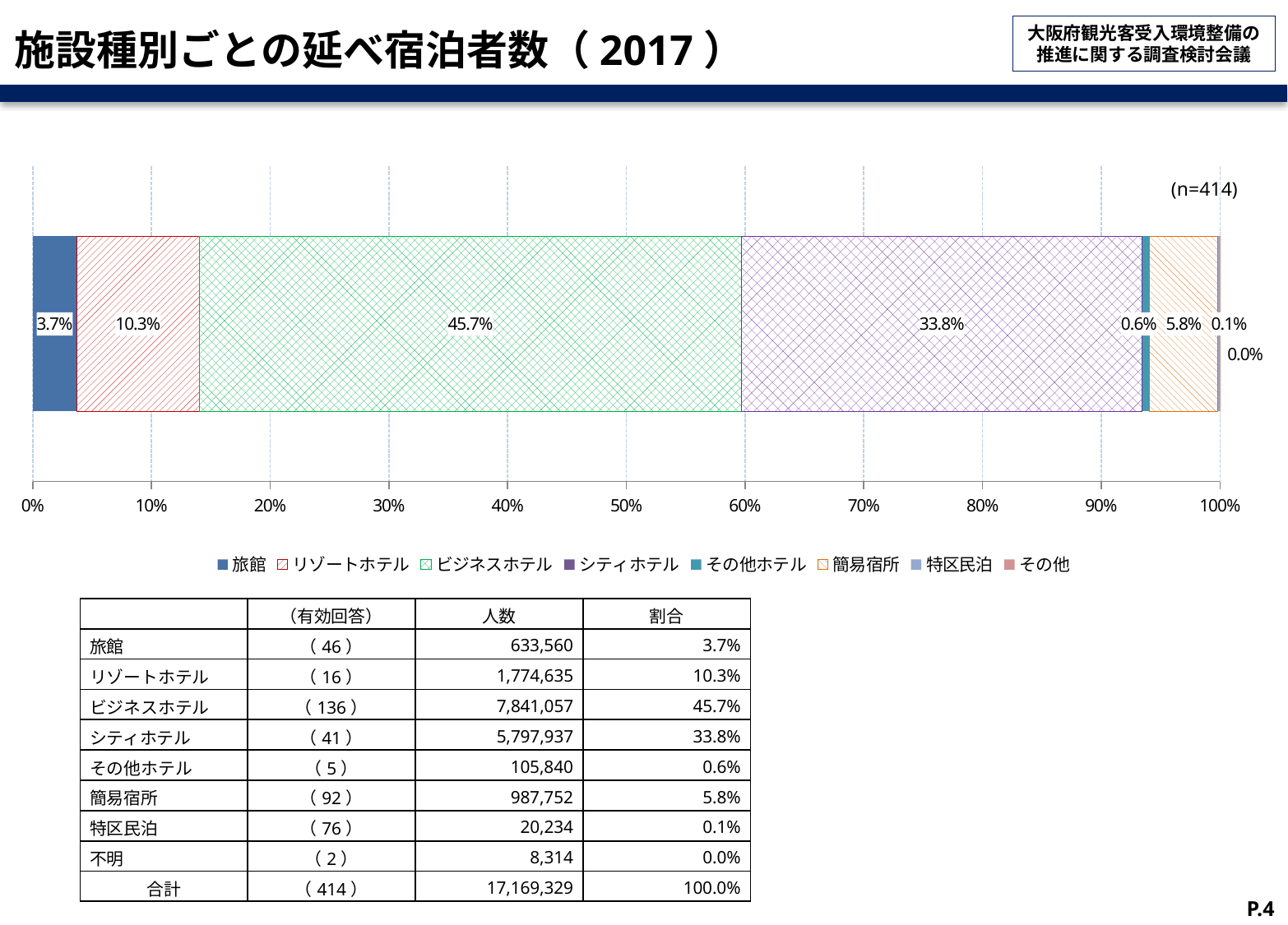
Which series has the smallest share in the stacked bar? その他 What is the value shown for シティホテル in the chart? 33.8% What kind of chart is shown on the slide? stacked bar chart What is the value shown for リゾートホテル in the chart? 10.3% What is the combined value of 旅館 and リゾートホテル in the chart? 14.0% Which series has the largest share in the stacked bar? ビジネスホテル What is the difference between the values for ビジネスホテル and シティホテル? 11.9% What is the value shown for ビジネスホテル in the chart? 45.7% How many series does the chart legend list? 8 Which is larger, the value for 旅館 or the value for 簡易宿所? 簡易宿所 What is the sample size (n) shown on the chart? n=414 What is the value shown for 簡易宿所 in the chart? 5.8%